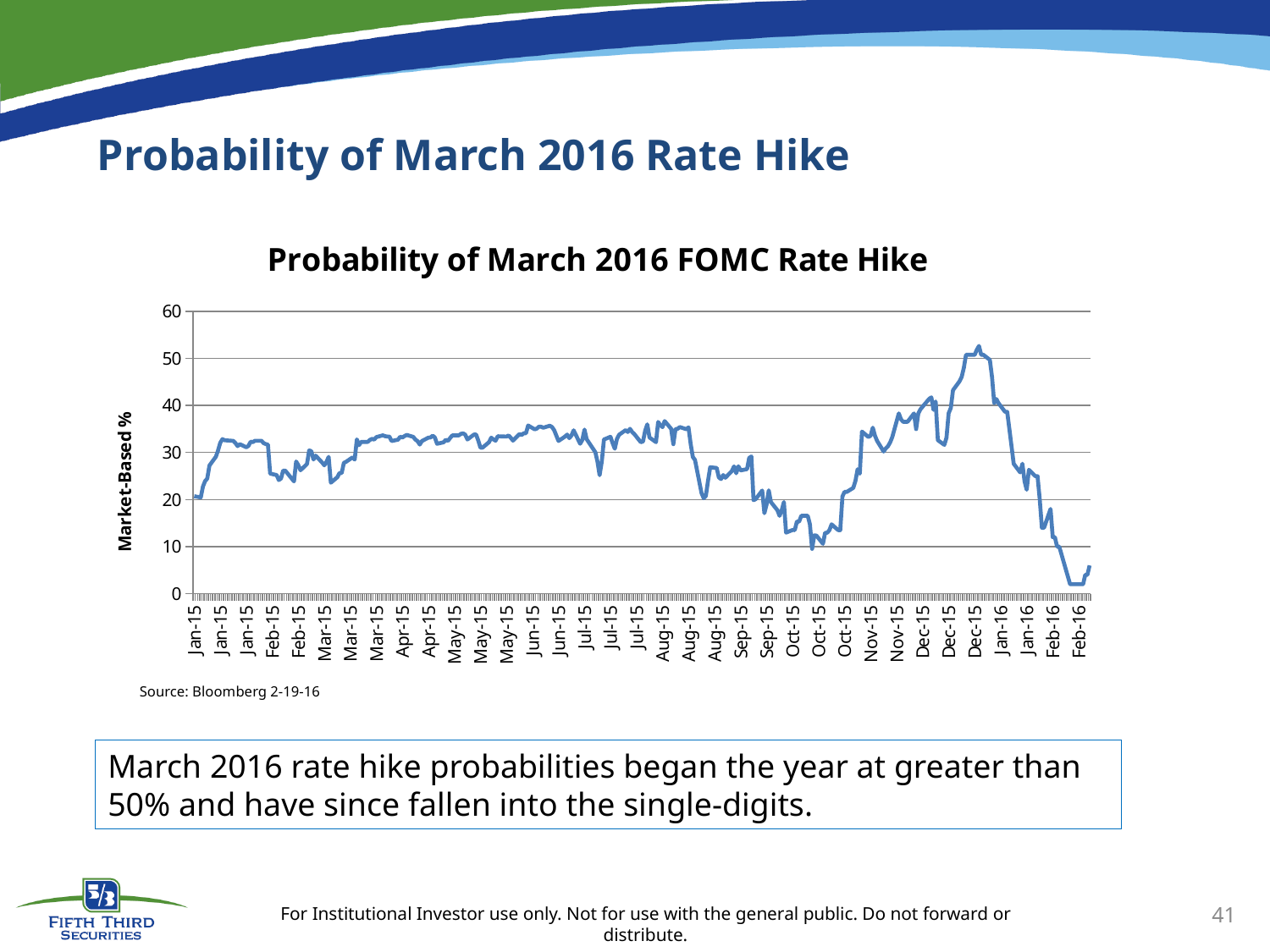
What kind of chart is shown on the slide? line chart Which is larger, the value in Jun-15 or the value in mid Oct-15? Jun-15 In which month does the line reach its lowest value? Feb-16 What is the title of the chart? Probability of March 2016 FOMC Rate Hike Is the peak value reached in Dec-15 greater or less than 50? greater In which month does the line reach its highest value? Dec-15 How many lines are plotted on the chart? 1 Is the value at the start of the line in Jan-15 greater or less than 30? less What is the label on the vertical axis of the chart? Market-Based % Do the values rise or fall from the Dec-15 peak to the end of the line in Feb-16? fall Is the value in Jun-15 greater or less than 30? greater